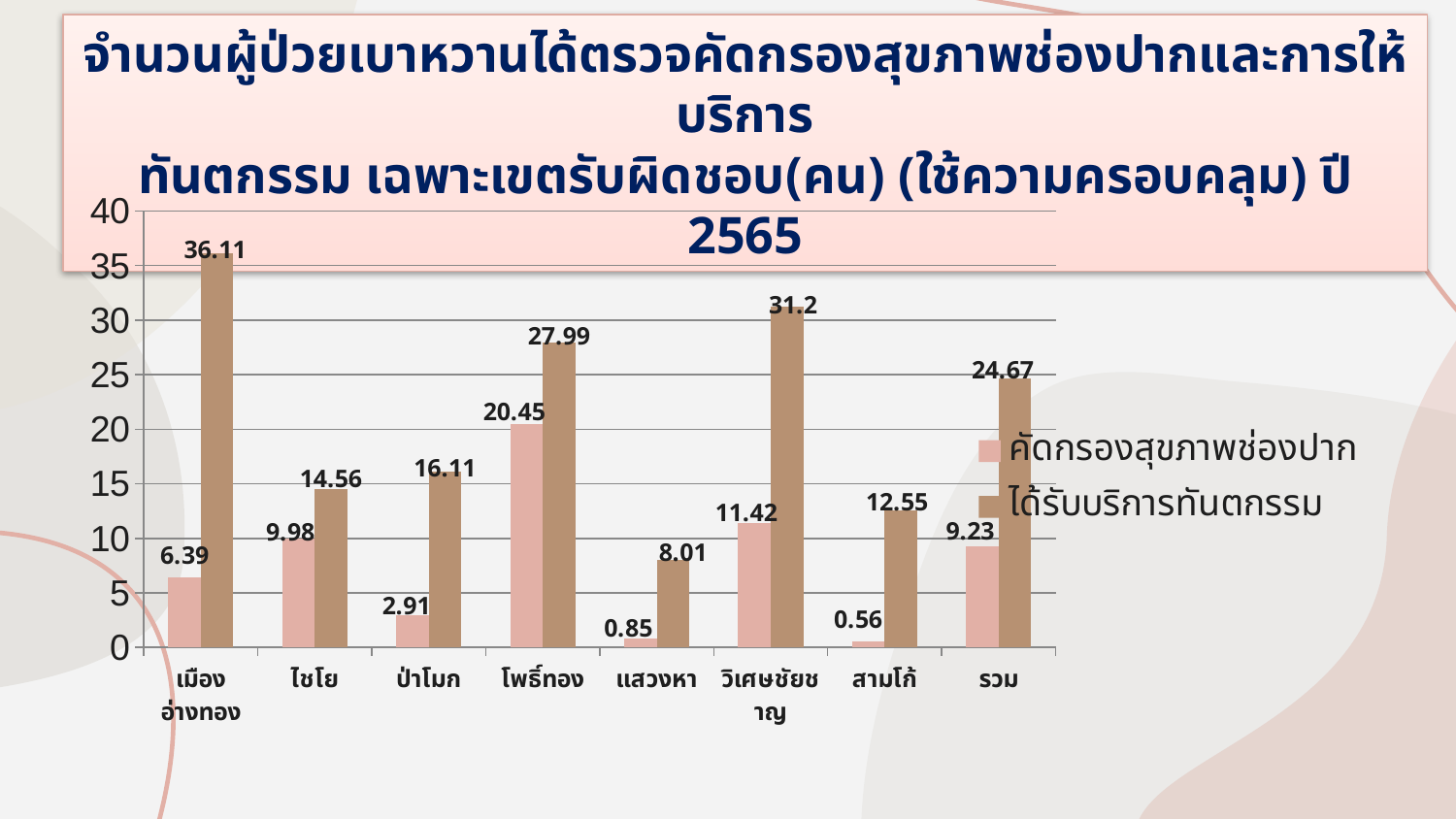
Which series is shown in brown in the legend? ได้รับบริการทันตกรรม What is the value of ได้รับบริการทันตกรรม for รวม? 24.67 Which is larger: คัดกรองสุขภาพช่องปาก in ไชโย or คัดกรองสุขภาพช่องปาก in ป่าโมก? ไชโย Is the value for ได้รับบริการทันตกรรม in แสวงหา greater or less than 10? less How many series does the legend list? 2 Which category has the lowest value for คัดกรองสุขภาพช่องปาก? สามโก้ Which category has the highest value for ได้รับบริการทันตกรรม? เมืองอ่างทอง What value is shown for คัดกรองสุขภาพช่องปาก in โพธิ์ทอง? 20.45 What is the difference between ได้รับบริการทันตกรรม and คัดกรองสุขภาพช่องปาก in วิเศษชัยชาญ? 19.78 What value is shown for ได้รับบริการทันตกรรม in เมืองอ่างทอง? 36.11 How many categories are shown on the x axis? 8 What kind of chart is shown on the slide? bar chart